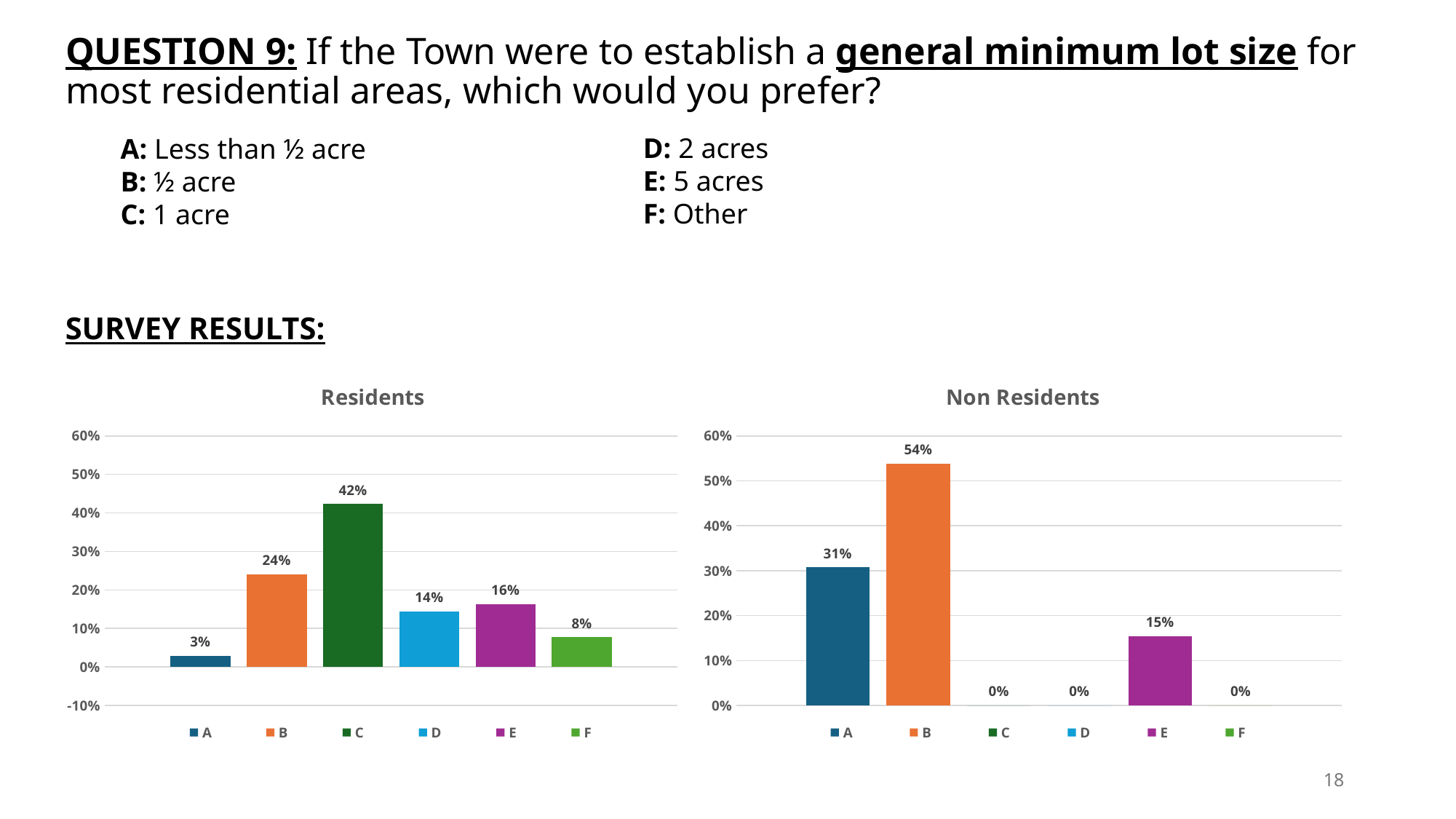
In the Residents chart, which category has the lowest value? A In the Non Residents chart, is the value for A greater or less than 20%? greater In the Non Residents chart, what is the difference between the values for B and A? 23% In the Residents chart, which category has the highest value? C In the Non Residents chart, which category has the highest value? B In the Non Residents chart, what is the value for B? 54% What kind of chart is the Non Residents chart? bar chart In the Residents chart, what is the difference between the values for C and B? 18% How many categories are shown in the Residents chart? 6 In the Non Residents chart, how many categories have a value of 0%? 3 In the Residents chart, what is the value for C? 42% In the Residents chart, which is larger, the value for E or the value for D? E